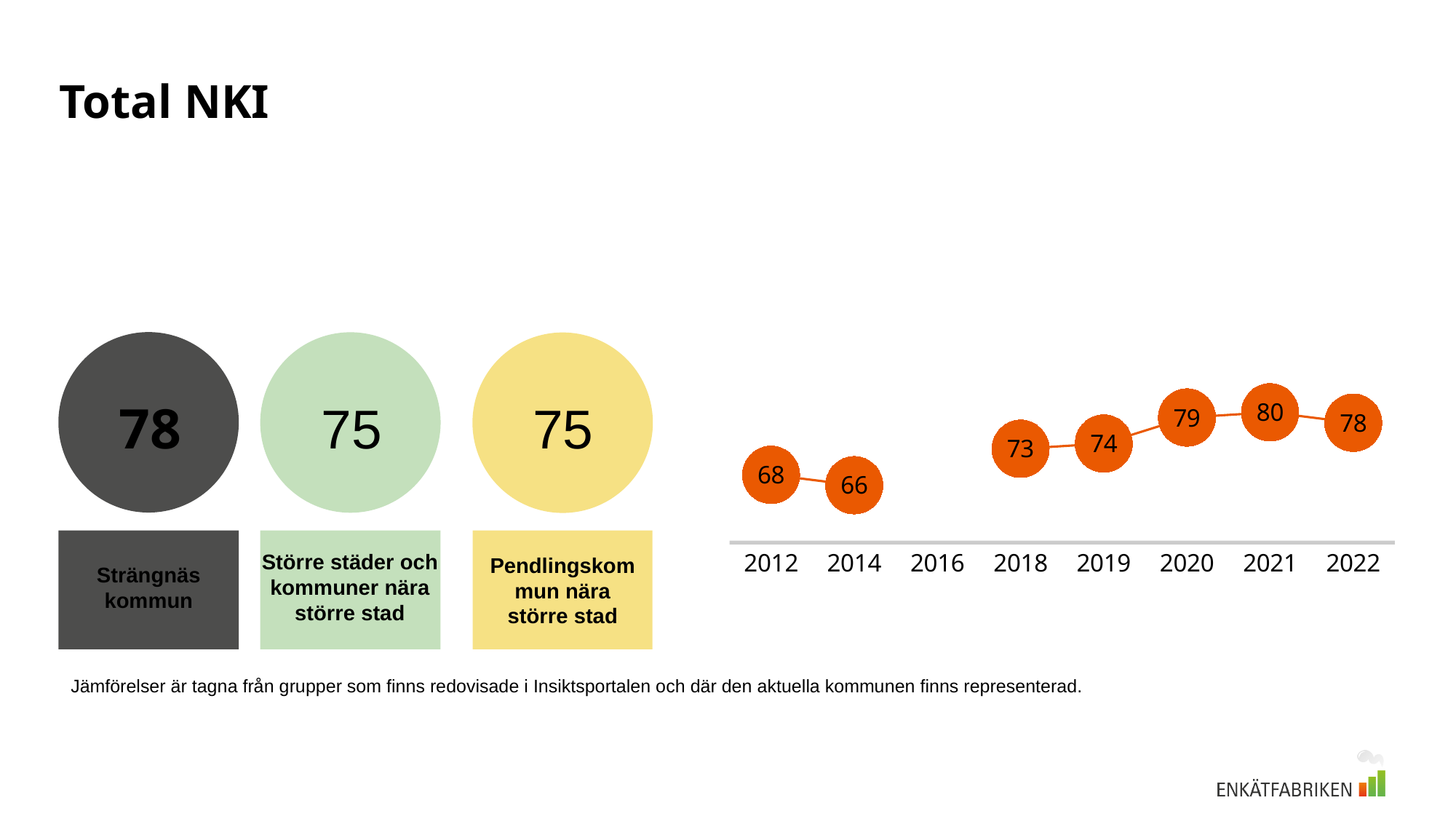
In the line chart, what is the NKI value for 2022? 78 In the line chart, what is the NKI value for 2020? 79 Which year on the x axis of the line chart has no plotted value? 2016 What kind of chart is shown on the right side of the slide? line chart In the line chart, which is larger, the value for 2012 or the value for 2014? 2012 In the line chart, what is the difference between the 2021 value and the 2014 value? 14 In the line chart, do the values rise or fall from 2018 to 2021? rise In the line chart, which year has the highest NKI value? 2021 In the line chart, which year has the lowest NKI value? 2014 In the line chart, what is the NKI value for 2012? 68 How many data points are plotted in the line chart? 7 In the line chart, what is the difference between the 2022 value and the 2018 value? 5